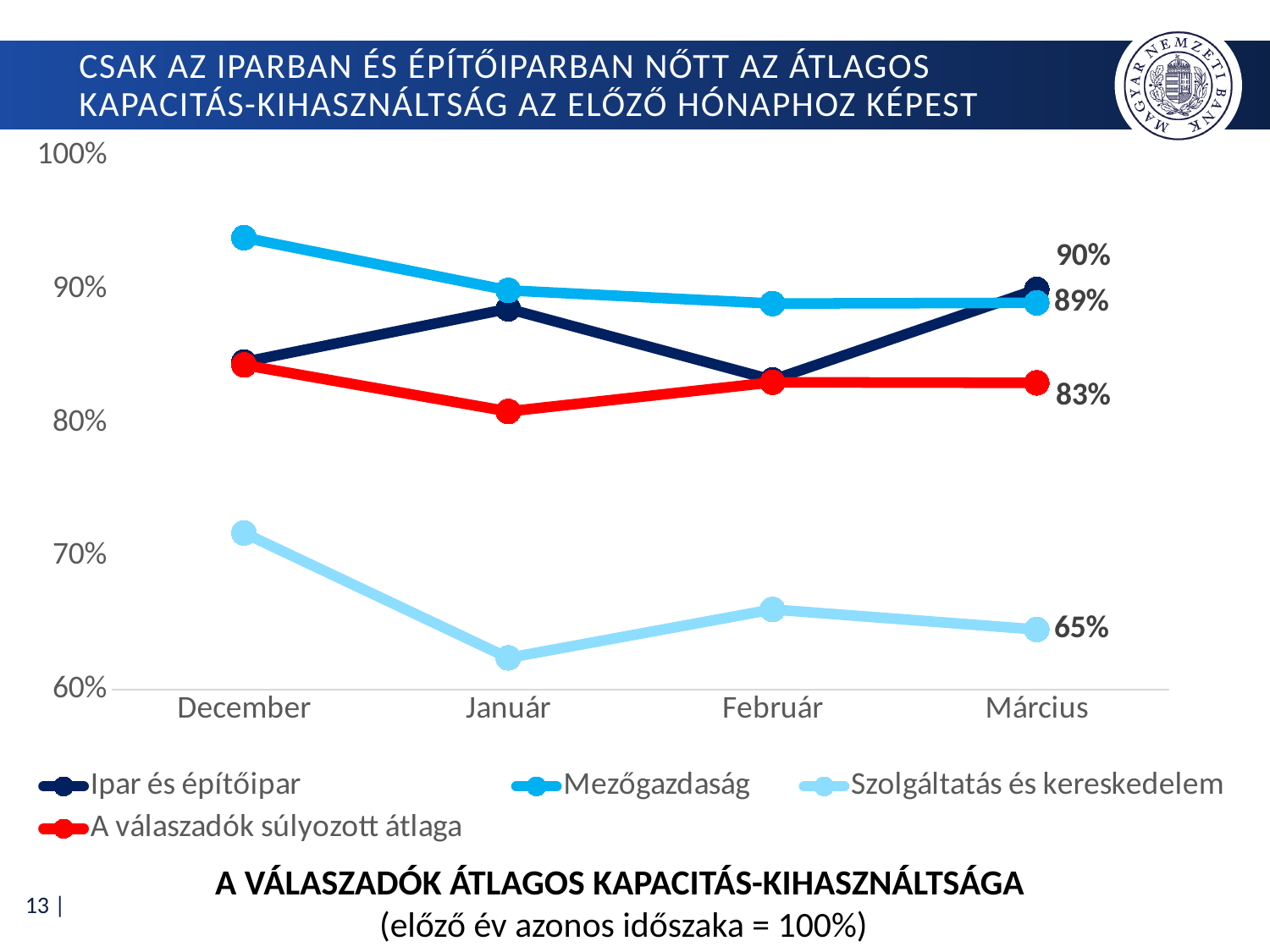
Which series has the lowest value in Március? Szolgáltatás és kereskedelem What is the value for Szolgáltatás és kereskedelem in Március? 65% What is the value for Ipar és építőipar in Március? 90% What is the value for Mezőgazdaság in Március? 89% What is the value for A válaszadók súlyozott átlaga in Március? 83% What kind of chart is shown on the slide? line chart Is the value for Mezőgazdaság in December greater or less than 90%? greater Is the value for Szolgáltatás és kereskedelem in December greater or less than 70%? greater Does the value for Szolgáltatás és kereskedelem rise or fall from December to Január? fall How many months are shown on the x axis? 4 What is the difference between Ipar és építőipar and Szolgáltatás és kereskedelem in Március? 25 percentage points How many series does the legend list? 4